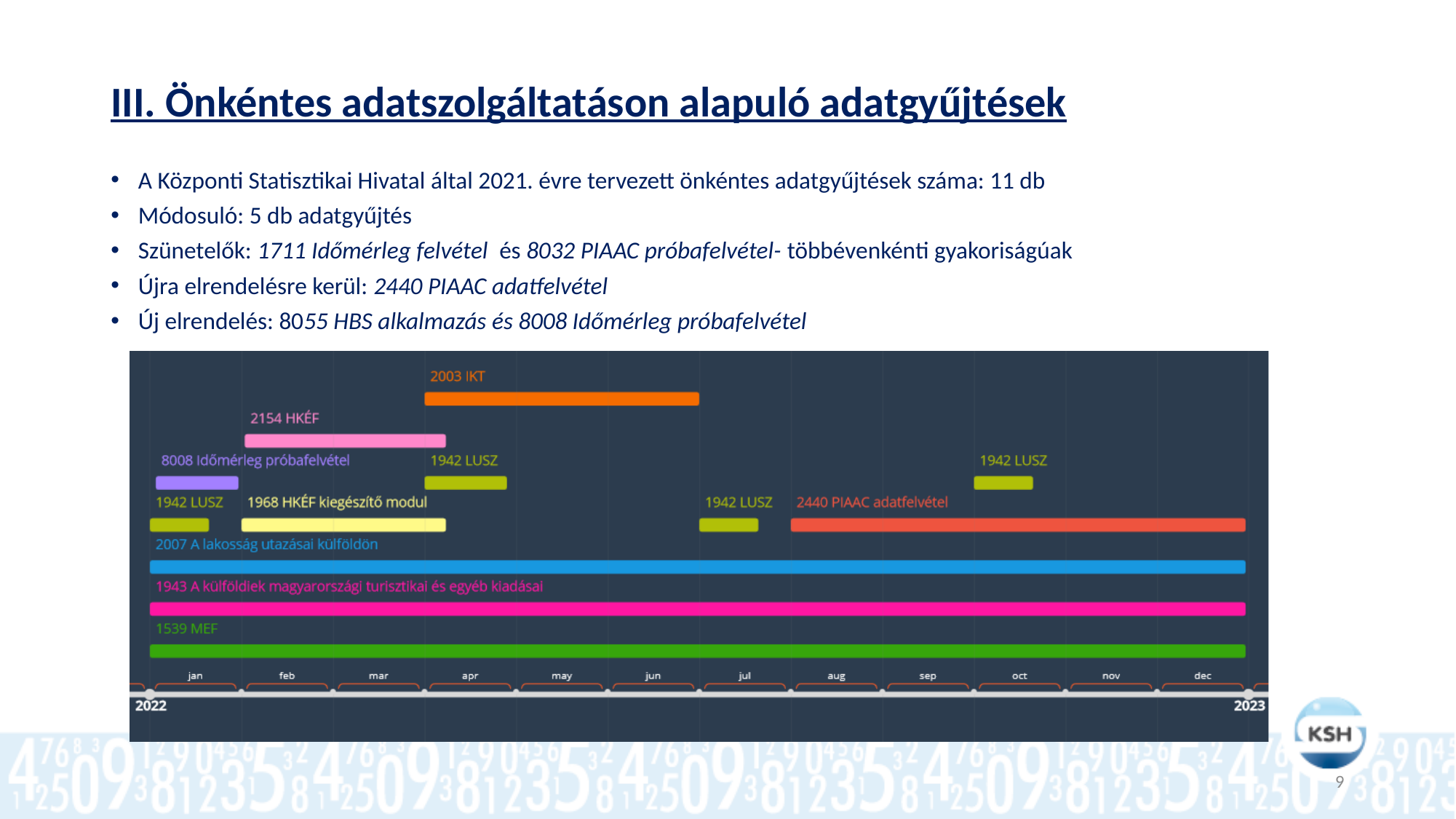
In which month is the bar for 8008 Időmérleg próbafelvétel placed? jan Which year is marked at the left end of the timeline axis? 2022 In which month does the bar for 2003 IKT begin? apr How many separate bars are labelled 1942 LUSZ on the timeline? 4 Which bar is longer, 2003 IKT or 2154 HKÉF? 2003 IKT Which data collections have bars spanning the entire year from jan to dec? 2007 A lakosság utazásai külföldön, 1943 A külföldiek magyarországi turisztikai és egyéb kiadásai, 1539 MEF Which year is marked at the right end of the timeline axis? 2023 In which month does the bar for 2440 PIAAC adatfelvétel begin? aug What colour is the bar for 1539 MEF? green What kind of chart is shown on the slide? timeline (Gantt) chart How many month labels are shown along the bottom axis of the timeline? 12